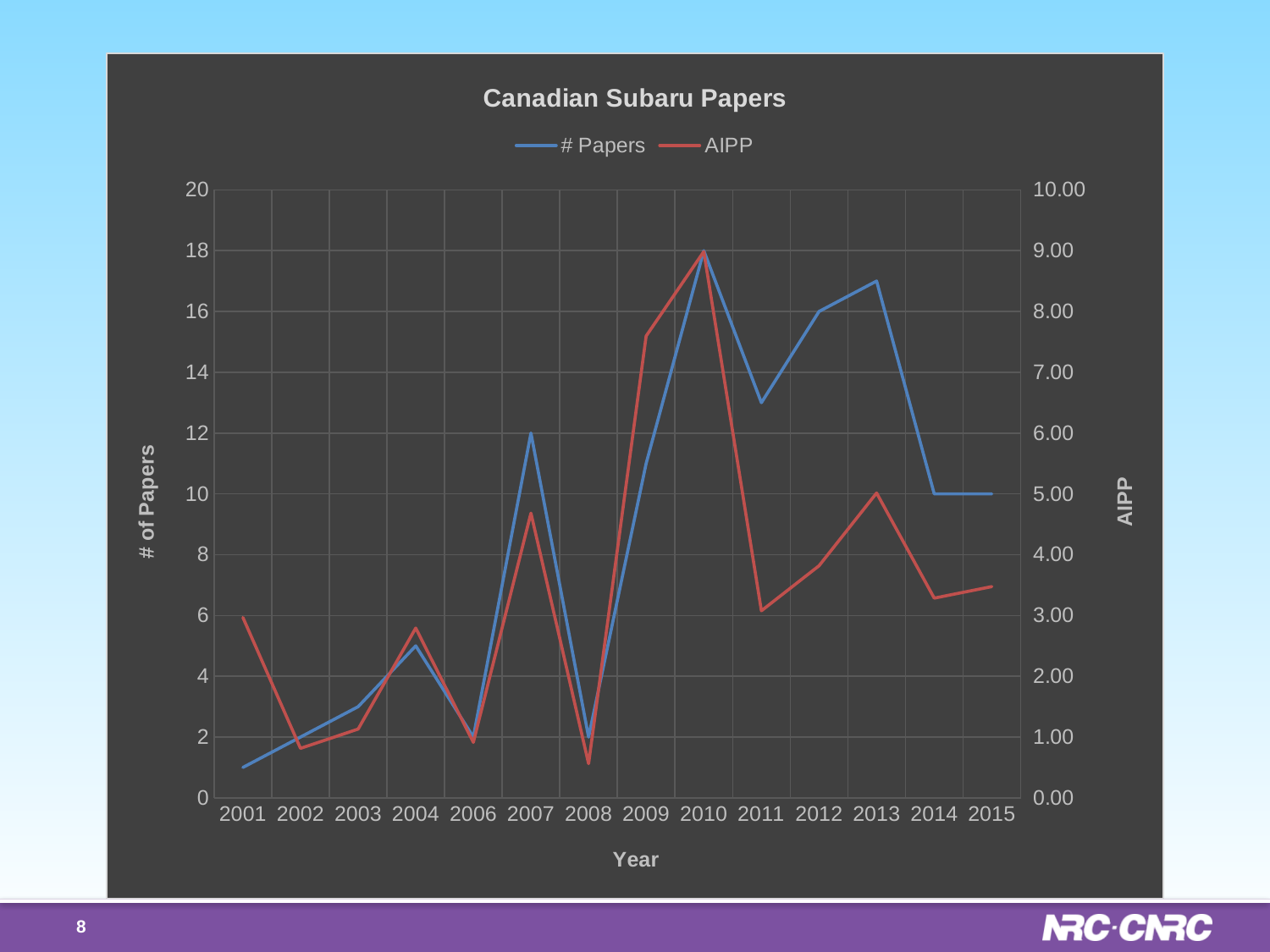
What is the value of # Papers in 2010? 18 What is the difference between # Papers in 2010 and in 2012? 2 What is the value of # Papers in 2012? 16 How many years are plotted along the x axis? 14 How many series does the legend list? 2 Does # Papers rise or fall from 2013 to 2015? fall In which year is # Papers highest? 2010 Is the AIPP value for 2009 greater or less than 7.00? greater In which year is AIPP lowest? 2008 What kind of chart is shown on the slide? line chart